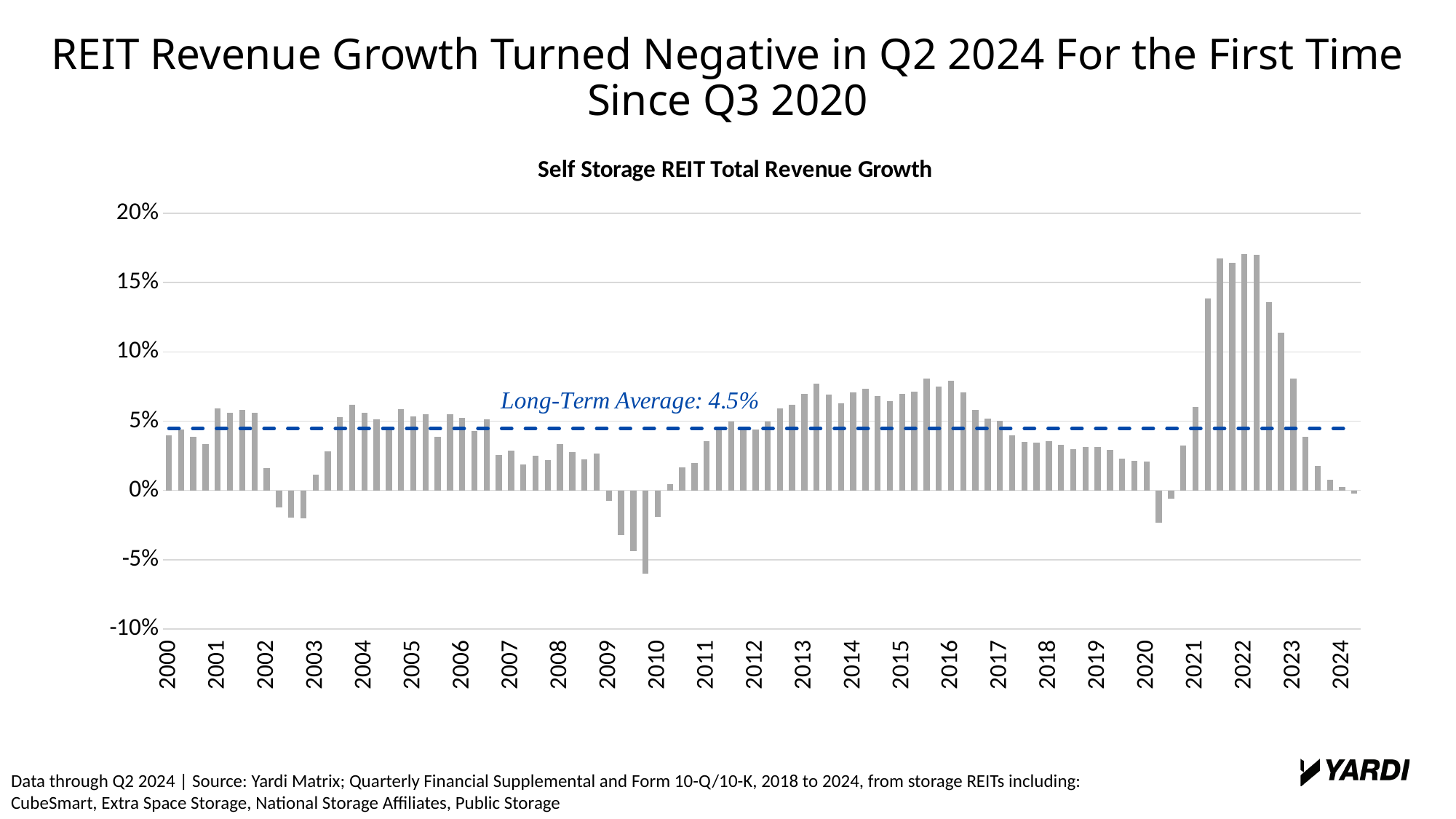
Do the bars rise or fall from 2022 to 2024? Fall Is the lowest bar in the chart, near 2010, greater or less than -5%? less How many year labels are shown on the x axis? 25 What colour is the dashed long-term average line? Blue Is the highest bar in 2022 greater or less than 15%? greater What is the title of the chart? Self Storage REIT Total Revenue Growth What long-term average value is labelled on the dashed line in the chart? 4.5% Is the tallest bar in 2021 greater or less than 10%? greater What kind of chart is shown on the slide? Bar chart In which year do the bars reach their highest values? 2022 Which is larger: the peak bar in 2022 or the peak bar in 2016? 2022